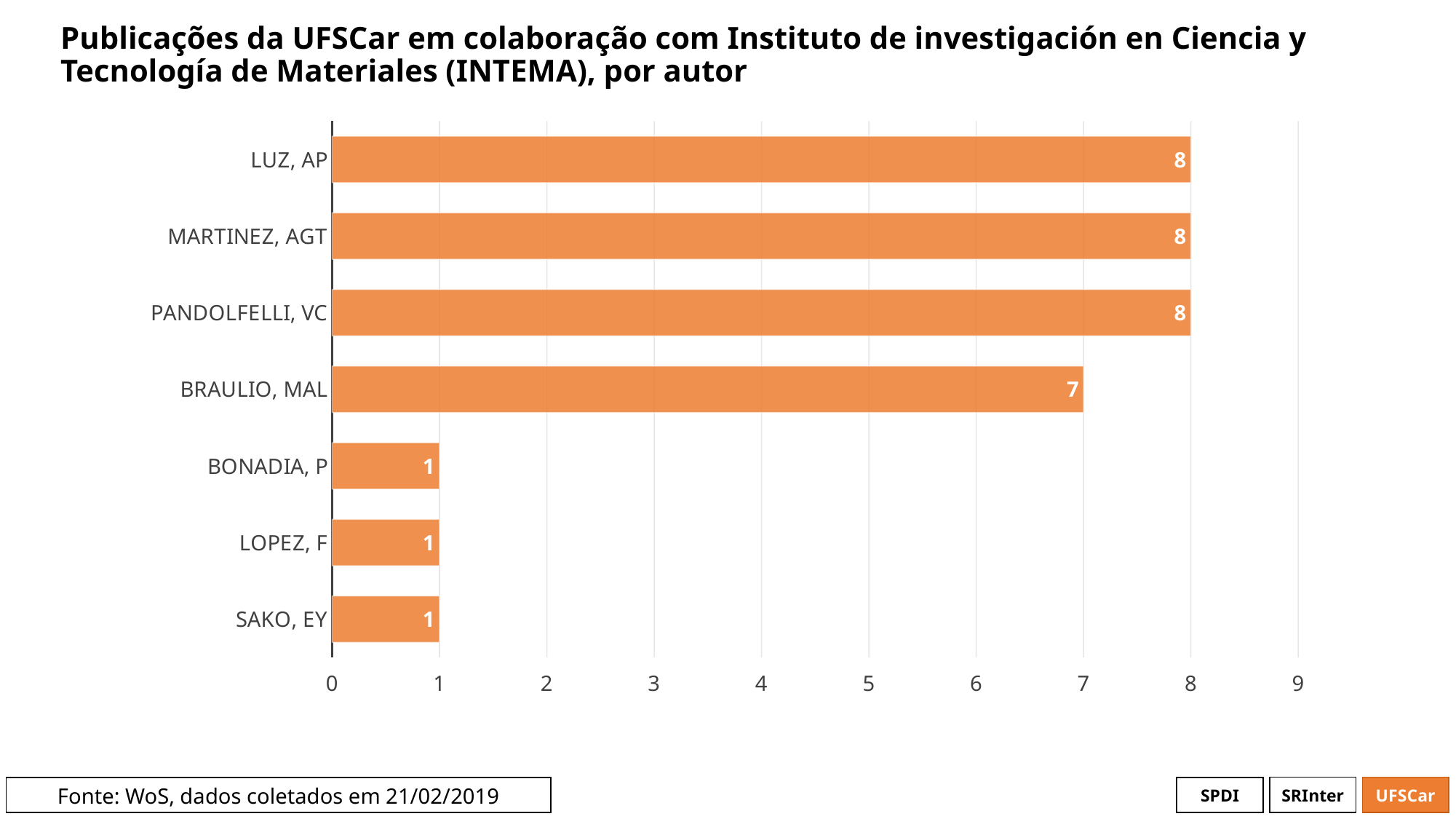
Which author has the fewest publications among LUZ, AP, BRAULIO, MAL and BONADIA, P? BONADIA, P What is the difference between the values for PANDOLFELLI, VC and BRAULIO, MAL? 1 What is the value for BRAULIO, MAL? 7 What is the difference between the values for LUZ, AP and LOPEZ, F? 7 What is the value for MARTINEZ, AGT? 8 How many authors are shown in the chart? 7 What kind of chart is shown on the slide? bar chart What is the data source stated at the bottom of the slide? WoS, dados coletados em 21/02/2019 What is the value for SAKO, EY? 1 How many publications does LUZ, AP have? 8 Is the value for BRAULIO, MAL greater or less than 5? greater Which is larger, the value for BRAULIO, MAL or the value for BONADIA, P? BRAULIO, MAL